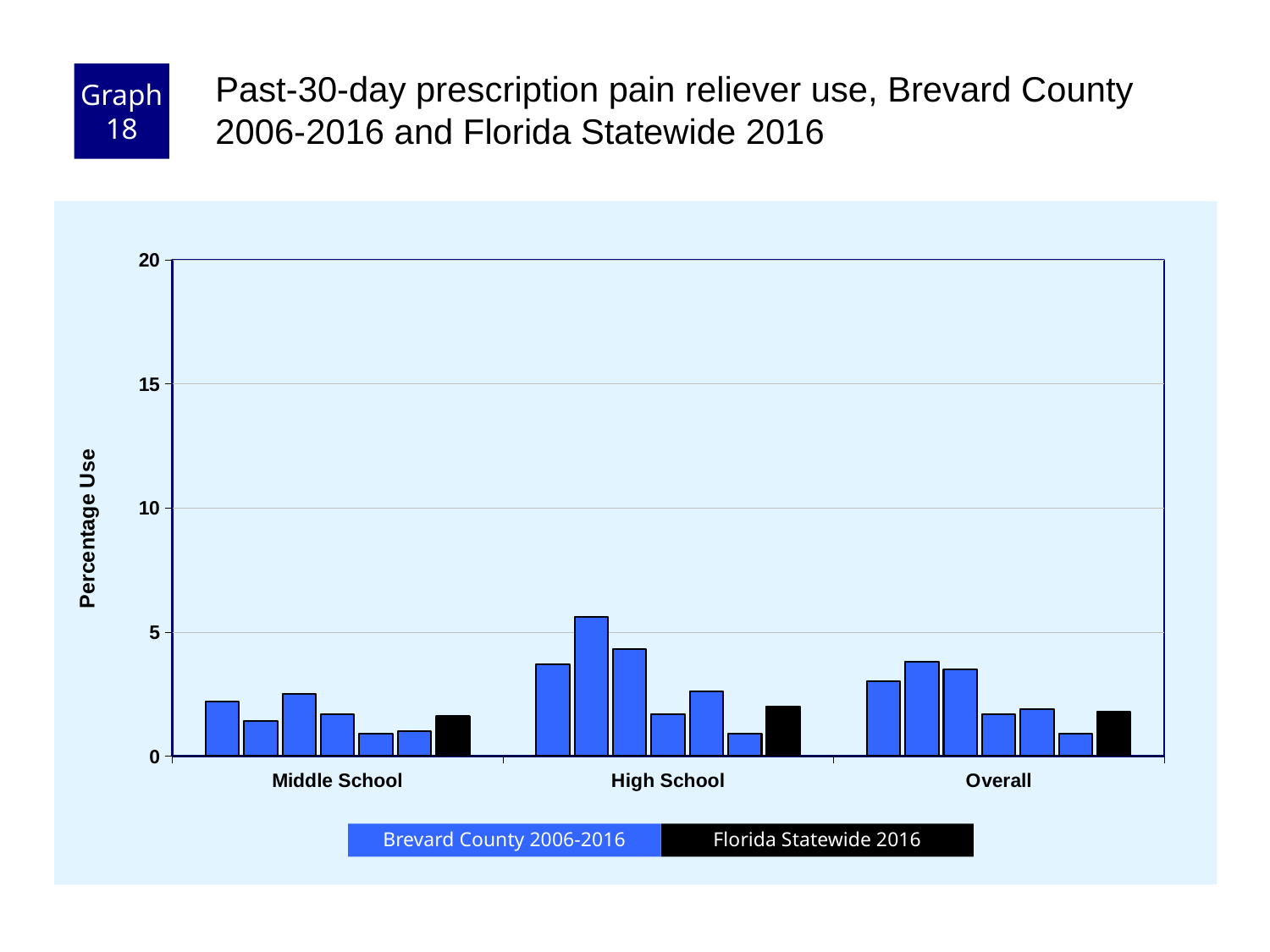
How many series does the legend list? 2 Is the tallest bar in the High School group greater or less than 10? less What kind of chart is shown on the slide? bar chart Is the tallest bar in the High School group greater or less than 5? greater What is the label on the y axis? Percentage Use Is the Florida Statewide 2016 value for High School greater or less than 5? less Which colour represents Florida Statewide 2016 in the legend? black How many categories are shown along the x axis? 3 Which is taller: the tallest Brevard County bar for High School or the tallest Brevard County bar for Middle School? High School Which category group contains the tallest bar in the chart? High School